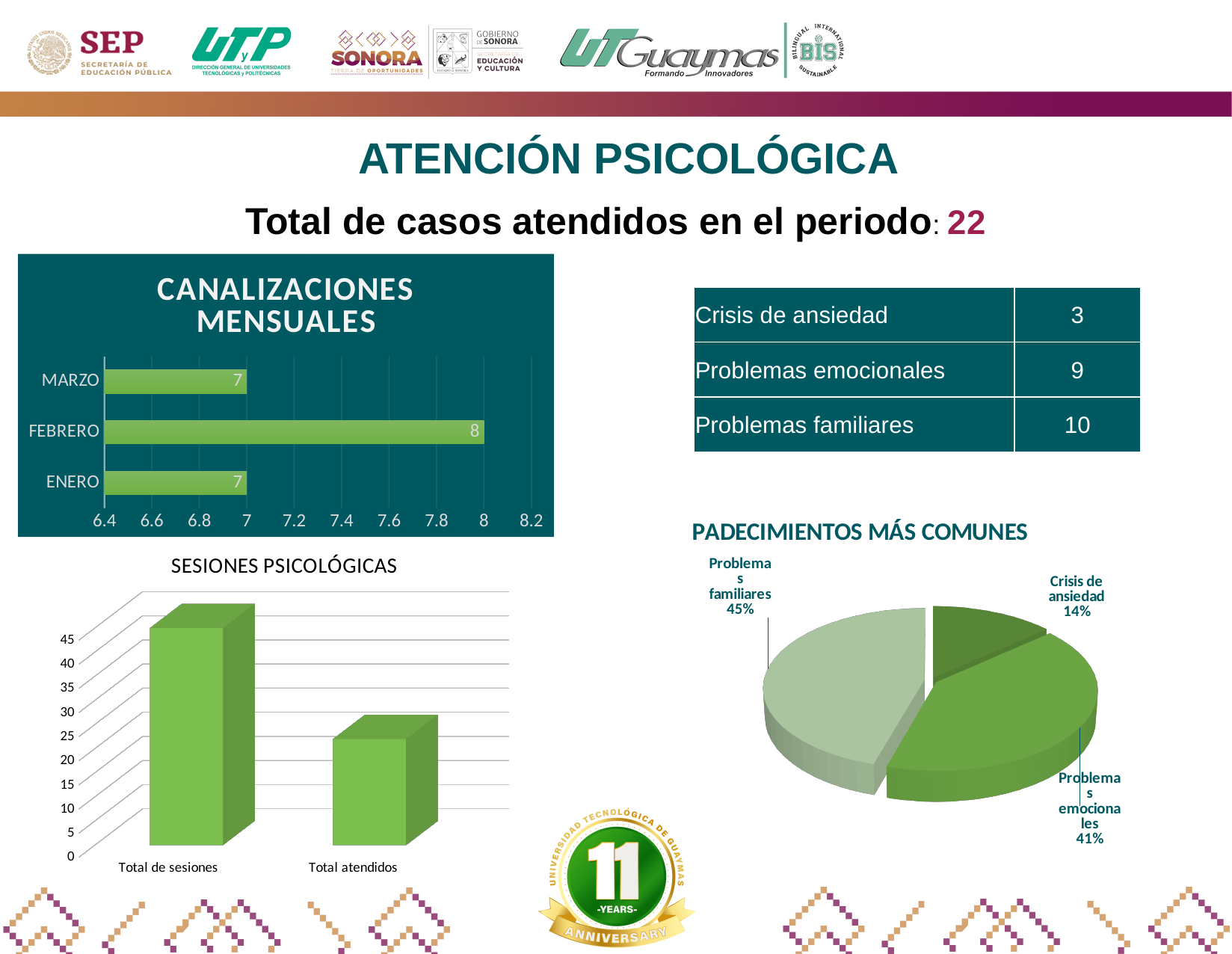
In the CANALIZACIONES MENSUALES chart, what is the difference between the values for FEBRERO and ENERO? 1 In the CANALIZACIONES MENSUALES chart, what is the value for MARZO? 7 How many months are shown in the CANALIZACIONES MENSUALES chart? 3 In the SESIONES PSICOLÓGICAS chart, which is larger: Total de sesiones or Total atendidos? Total de sesiones In the CANALIZACIONES MENSUALES chart, what is the value for FEBRERO? 8 In the SESIONES PSICOLÓGICAS chart, is the value for Total atendidos greater or less than 30? less What kind of chart is the PADECIMIENTOS MÁS COMUNES chart? Pie chart In the CANALIZACIONES MENSUALES chart, which month has the highest value? FEBRERO In the PADECIMIENTOS MÁS COMUNES pie chart, what share does Problemas familiares have? 45% What kind of chart is the CANALIZACIONES MENSUALES chart? Bar chart In the PADECIMIENTOS MÁS COMUNES pie chart, which category has the smallest share? Crisis de ansiedad In the SESIONES PSICOLÓGICAS chart, is the value for Total de sesiones greater or less than 40? greater